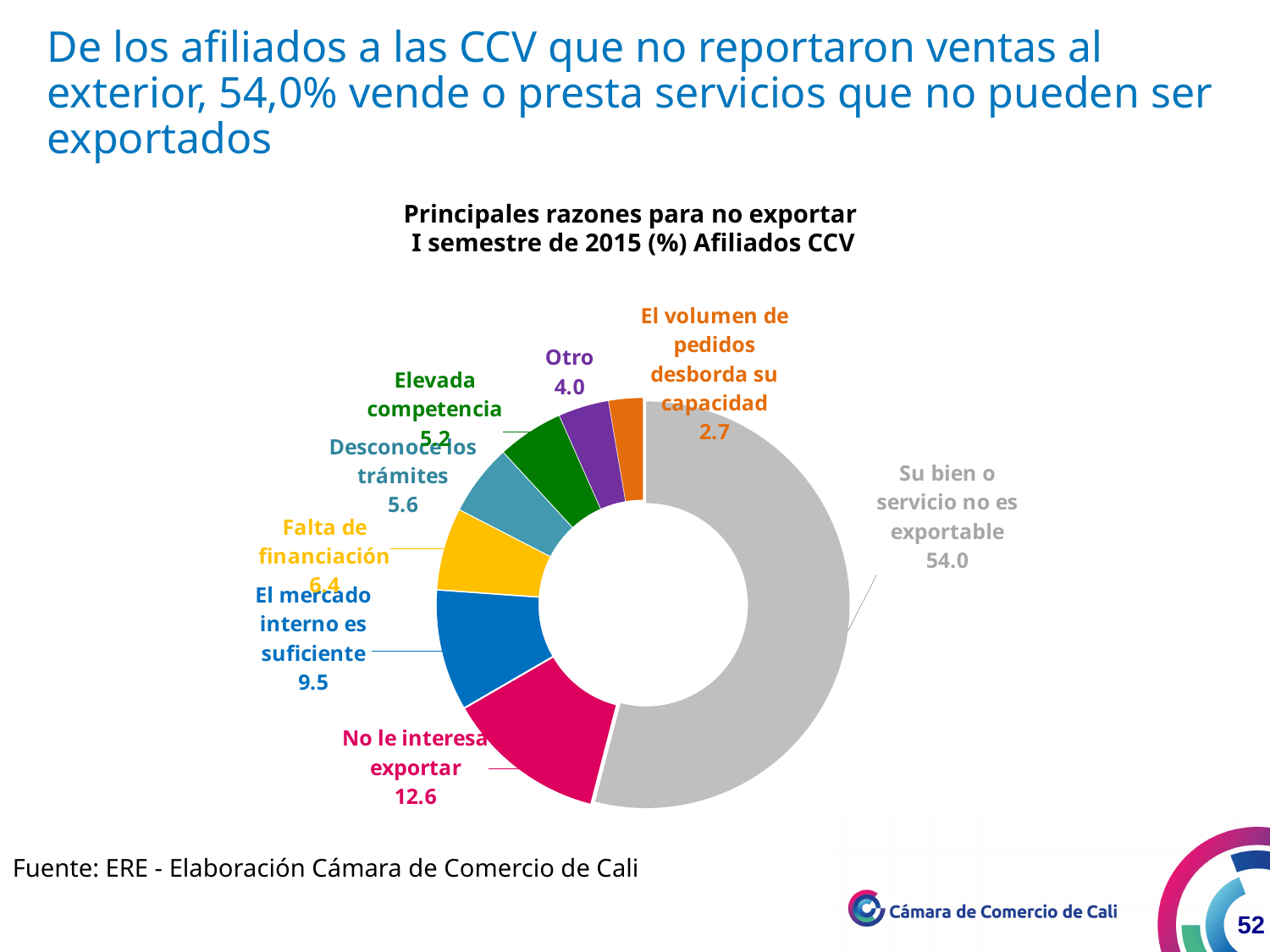
Which is larger: 'El mercado interno es suficiente' or 'Desconoce los trámites'? El mercado interno es suficiente What is the value for 'Otro'? 4.0 Which reason has the smallest share in the chart? El volumen de pedidos desborda su capacidad What is the value for 'Su bien o servicio no es exportable'? 54.0 How many categories (reasons) are shown in the chart? 8 What is the value for 'No le interesa exportar'? 12.6 What is the value for 'El volumen de pedidos desborda su capacidad'? 2.7 What is the value for 'El mercado interno es suficiente'? 9.5 What is the value for 'Desconoce los trámites'? 5.6 What kind of chart is shown on the slide? Doughnut (pie) chart Which reason has the largest share in the chart? Su bien o servicio no es exportable What is the difference between the values for 'Su bien o servicio no es exportable' and 'No le interesa exportar'? 41.4